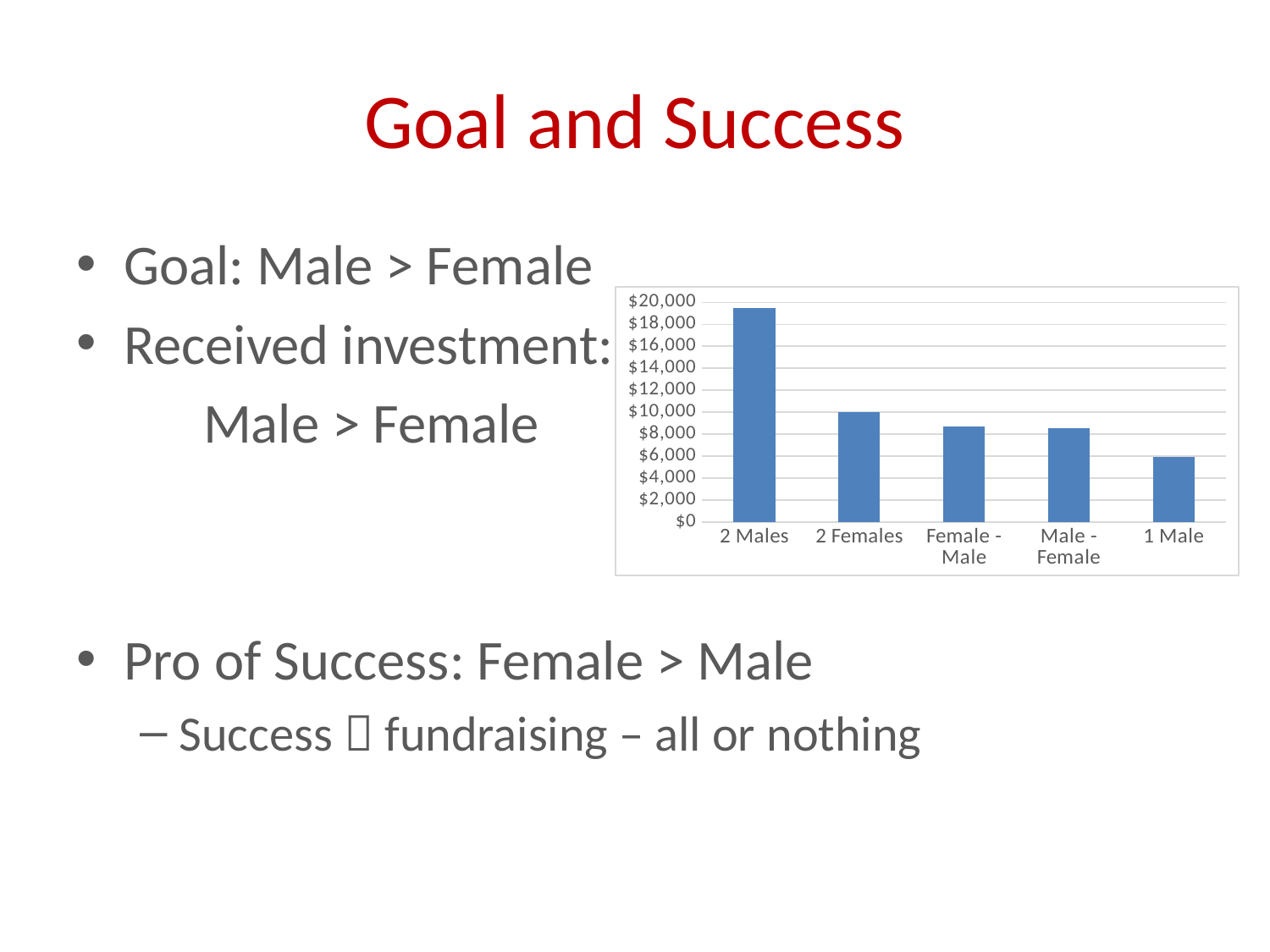
Is the value for Male - Female greater or less than $6,000? greater Which is larger, the value for 2 Females or the value for 1 Male? 2 Females Which category has the lowest value on the chart? 1 Male Is the value for Female - Male greater or less than $10,000? less Which is larger, the value for 2 Males or the value for 2 Females? 2 Males Is the value for 2 Males greater or less than $18,000? greater How many categories are plotted on the chart? 5 What kind of chart is shown on the slide? bar chart What colour are the bars in the chart? blue Which category has the highest value on the chart? 2 Males Do the bar values rise or fall from left to right across the chart? fall